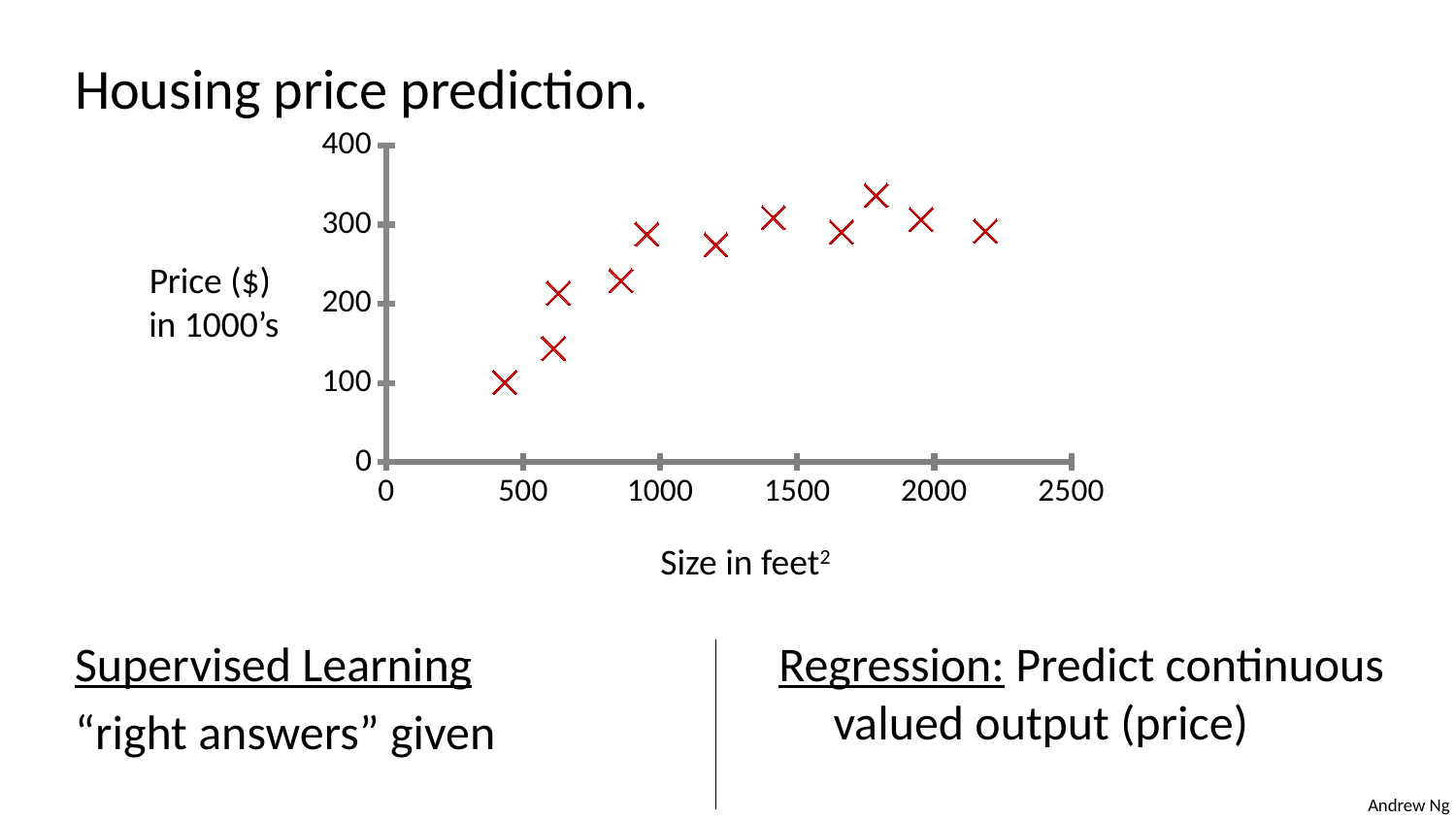
Is the price for the house of about 600 square feet (the lower of the two points near 600) greater or less than 200? less What is the title of the slide containing the chart? Housing price prediction. Do prices generally rise or fall as house size increases from 0 to 1500 square feet? rise How many data points are plotted on the chart? 11 Is the price for the house of about 1800 square feet greater or less than 300? greater Which data point has the highest price: the one near 1800 square feet or the one near 1400 square feet? the one near 1800 square feet Is the price for the house of about 1200 square feet greater or less than 300? less What is the label of the x axis? Size in feet² What kind of chart is shown on the slide? scatter plot